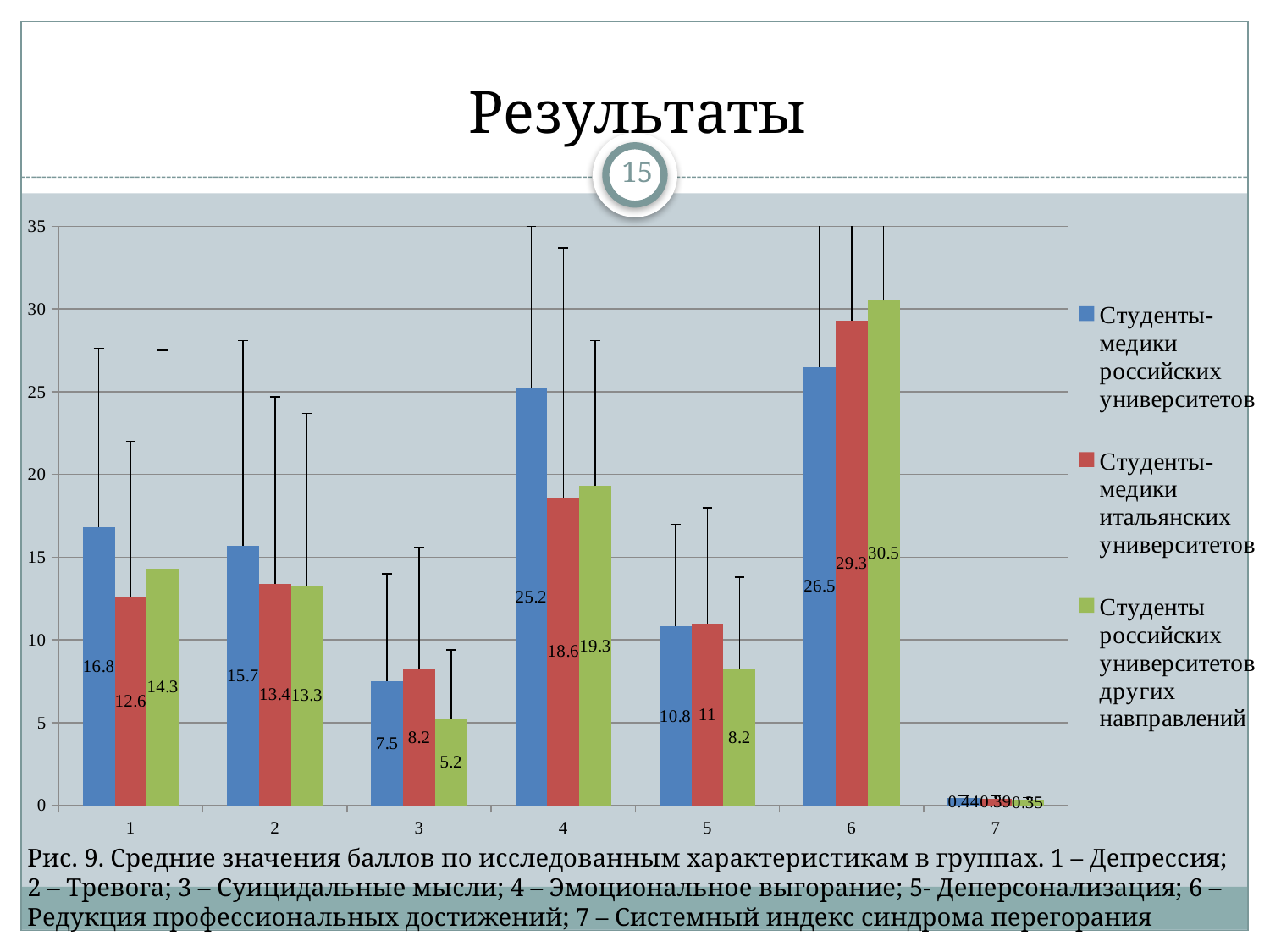
What is the difference between the values for Студенты-медики российских университетов and Студенты-медики итальянских университетов in category 4? 6.6 What kind of chart is shown on the slide? bar chart What is the value for category 6 for Студенты российских университетов других направлений? 30.5 Which category has the highest value for Студенты-медики российских университетов? 6 Is the value for category 2 for Студенты-медики российских университетов greater or less than 15? greater In category 3, which series has the larger value: Студенты-медики итальянских университетов or Студенты российских университетов других направлений? Студенты-медики итальянских университетов How many series does the legend list? 3 Which colour represents Студенты-медики итальянских университетов in the legend? red What is the value for category 1 for Студенты-медики российских университетов? 16.8 How many categories are shown on the x axis? 7 What is the value for category 4 for Студенты-медики итальянских университетов? 18.6 Which category has the lowest value for Студенты российских университетов других направлений? 7